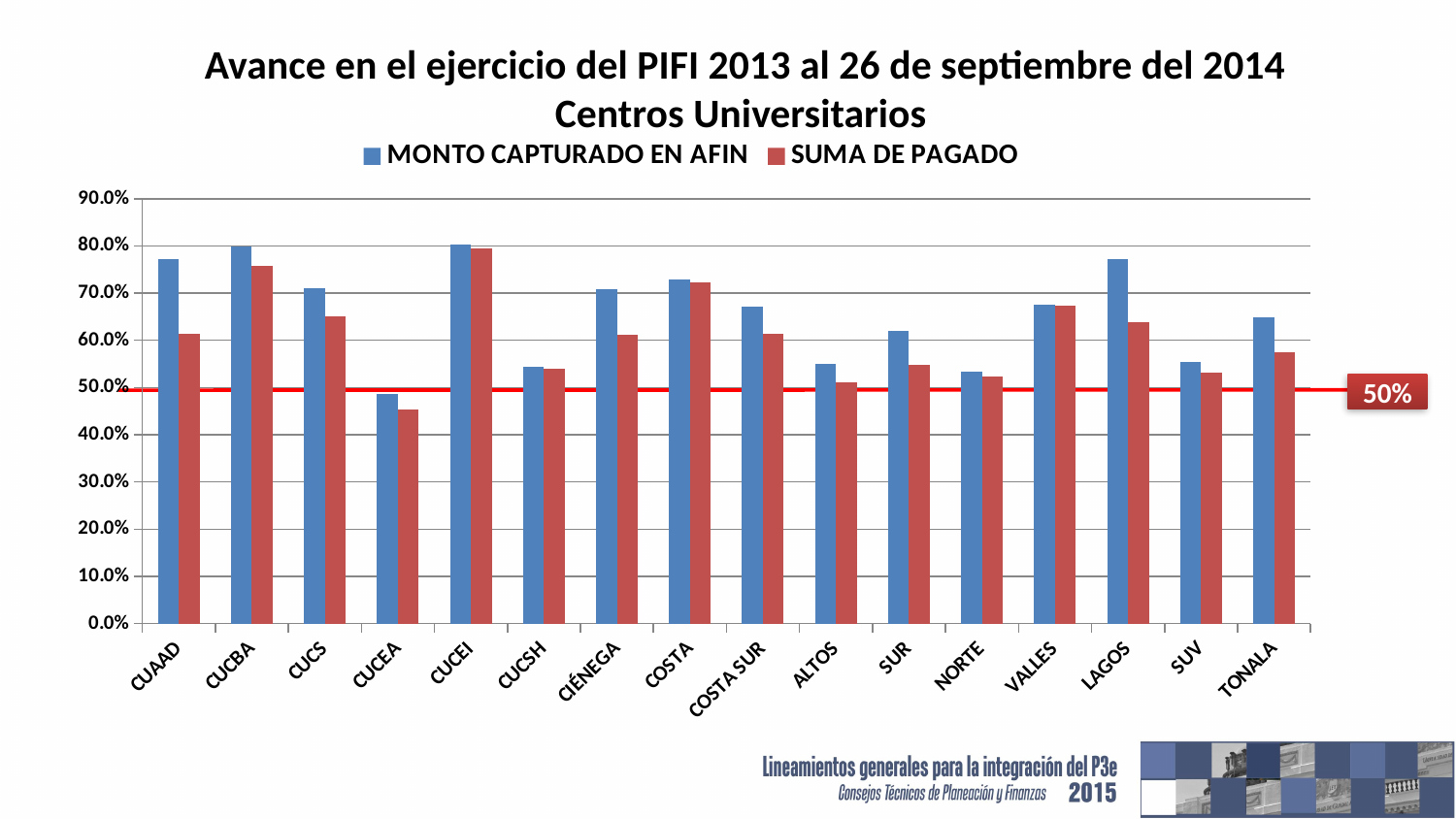
Which centre has the highest SUMA DE PAGADO value? CUCEI Is the SUMA DE PAGADO value for LAGOS greater or less than 60%? greater What kind of chart is shown on the slide? bar chart Is the MONTO CAPTURADO EN AFIN value for CUCEA greater or less than 50%? less Is the MONTO CAPTURADO EN AFIN value for SUR greater or less than 70%? less Which centre has the lowest SUMA DE PAGADO value? CUCEA Which centre has the lowest MONTO CAPTURADO EN AFIN value? CUCEA How many university centres (categories) are shown on the x axis? 16 How many series does the legend list? 2 For LAGOS, which is larger: MONTO CAPTURADO EN AFIN or SUMA DE PAGADO? MONTO CAPTURADO EN AFIN What percentage does the red horizontal reference line mark? 50%